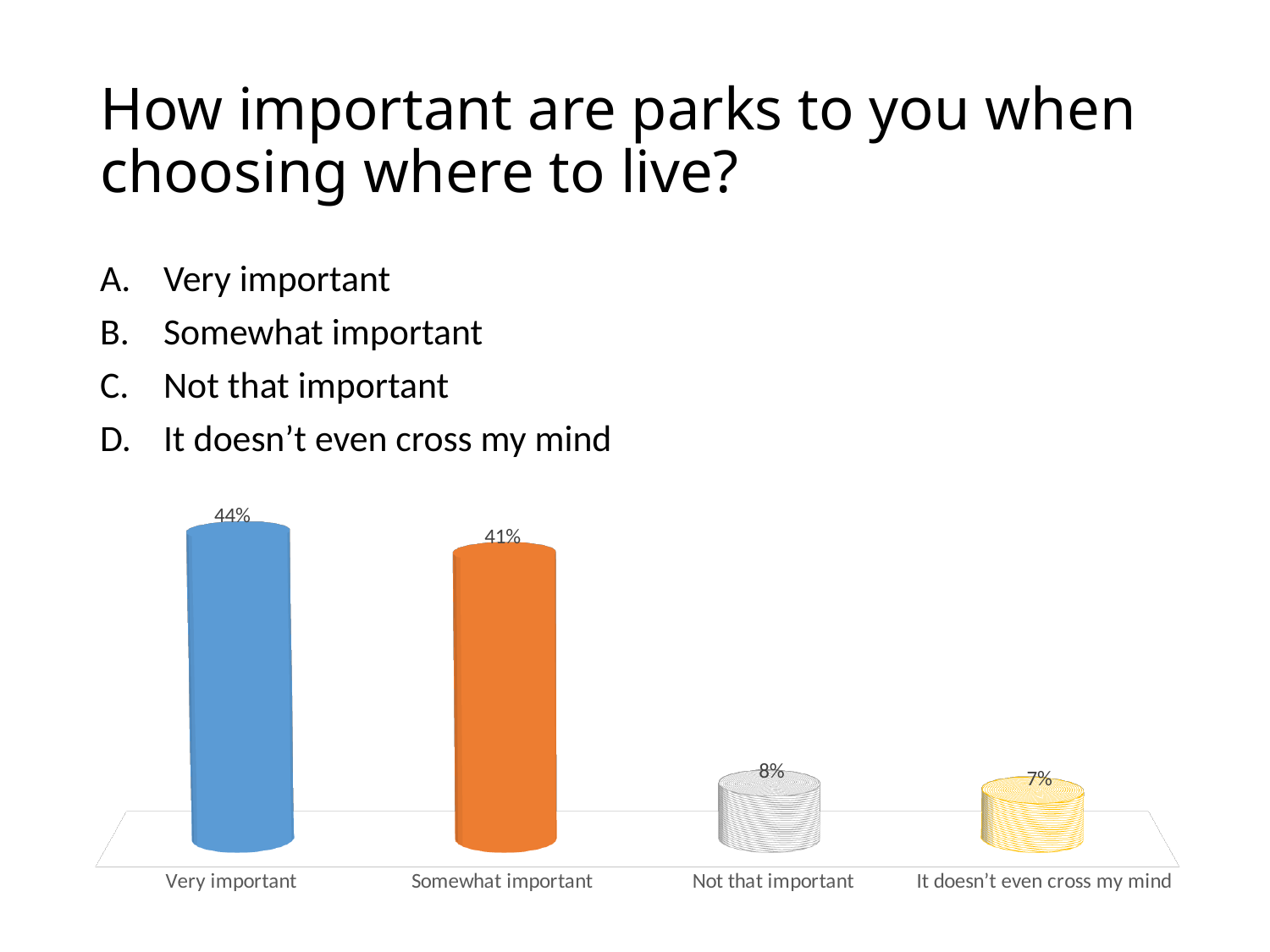
What kind of chart is shown on the slide? Bar chart What is the value for "Very important"? 44% Which is larger, the value for "Very important" or the value for "Not that important"? Very important Which category has the highest value? Very important What is the difference between the values for "Very important" and "Somewhat important"? 3% What is the value for "Not that important"? 8% What colour is the bar for "Somewhat important"? Orange Which category has the lowest value? It doesn't even cross my mind How many categories are shown in the chart? 4 What is the value for "Somewhat important"? 41% What is the difference between the values for "Somewhat important" and "Not that important"? 33% What is the value for "It doesn't even cross my mind"? 7%